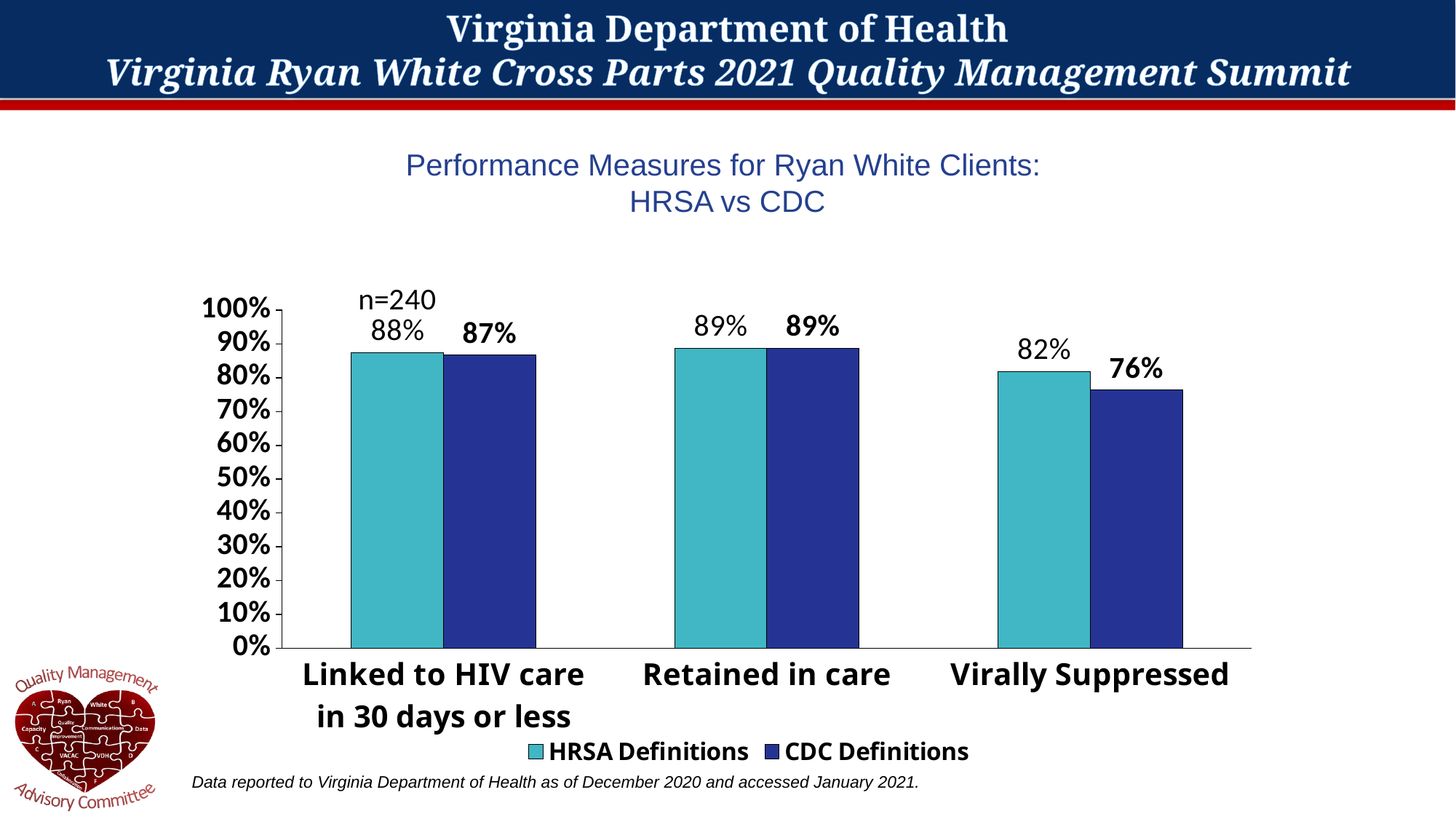
What is the HRSA Definitions value for Virally Suppressed? 82% For Virally Suppressed, which is larger: the HRSA Definitions value or the CDC Definitions value? HRSA Definitions How many series does the legend list? 2 Which category has the highest HRSA Definitions value? Retained in care What kind of chart is shown on the slide? Bar chart What is the CDC Definitions value for Retained in care? 89% How many categories are shown on the x axis? 3 What is the CDC Definitions value for Virally Suppressed? 76% What sample size (n) is printed above the Linked to HIV care in 30 days or less bars? n=240 What is the difference between the HRSA Definitions and CDC Definitions values for Virally Suppressed? 6% Which category has the lowest CDC Definitions value? Virally Suppressed What is the HRSA Definitions value for Linked to HIV care in 30 days or less? 88%